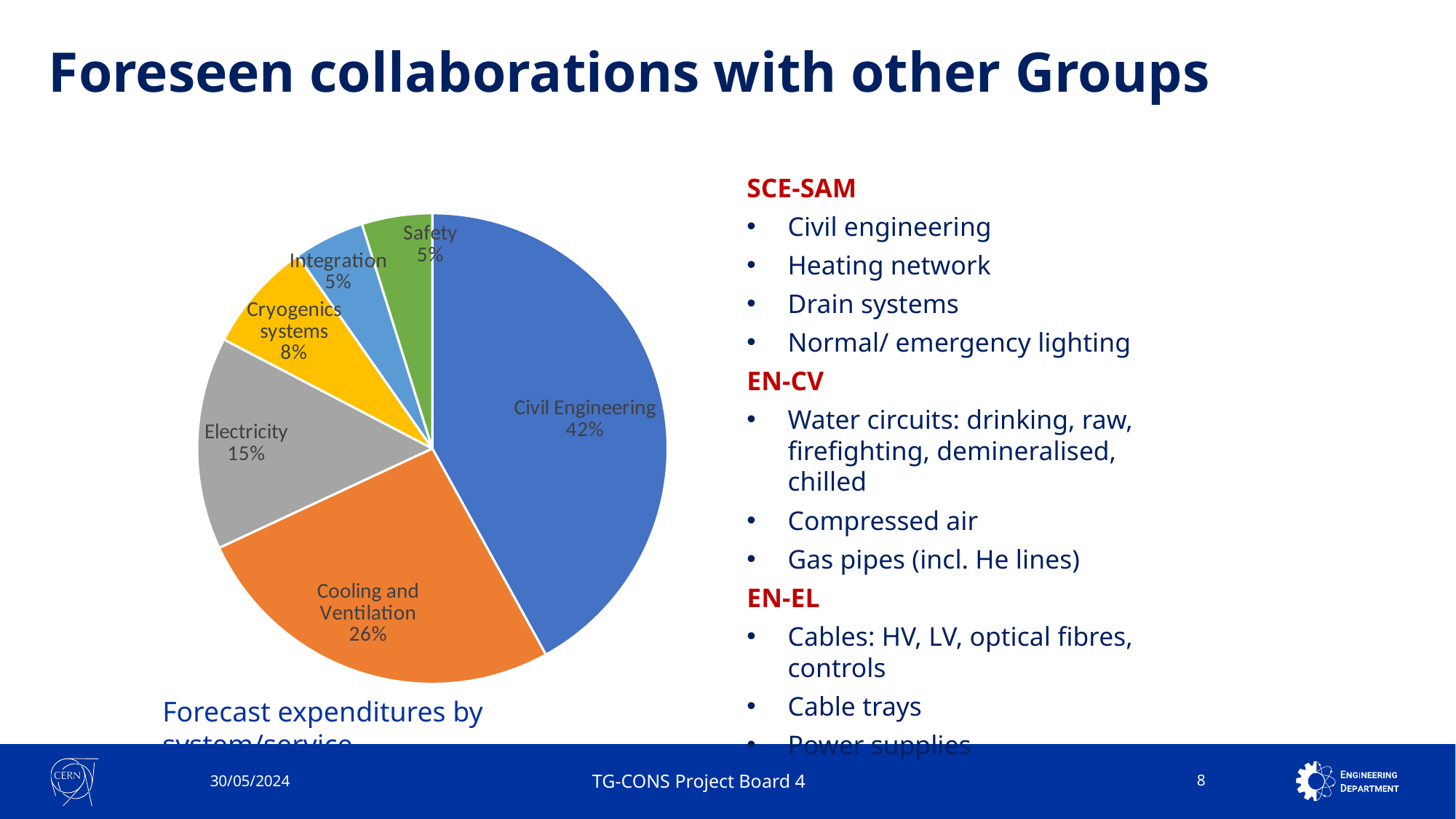
How many categories are shown in the pie chart? 6 Which category has the largest slice of the pie? Civil Engineering What percentage is shown for Electricity? 15% What is the difference in percentage points between Electricity and Cryogenics systems? 7 What colour is the Cooling and Ventilation slice? Orange What percentage is shown for Cooling and Ventilation? 26% What is the difference in percentage points between Civil Engineering and Cooling and Ventilation? 16 What share of the pie does Civil Engineering represent? 42% What kind of chart is shown on the slide? Pie chart What percentage is shown for Cryogenics systems? 8% Which is larger, the Electricity slice or the Cryogenics systems slice? Electricity What is the combined percentage of Integration and Safety? 10%